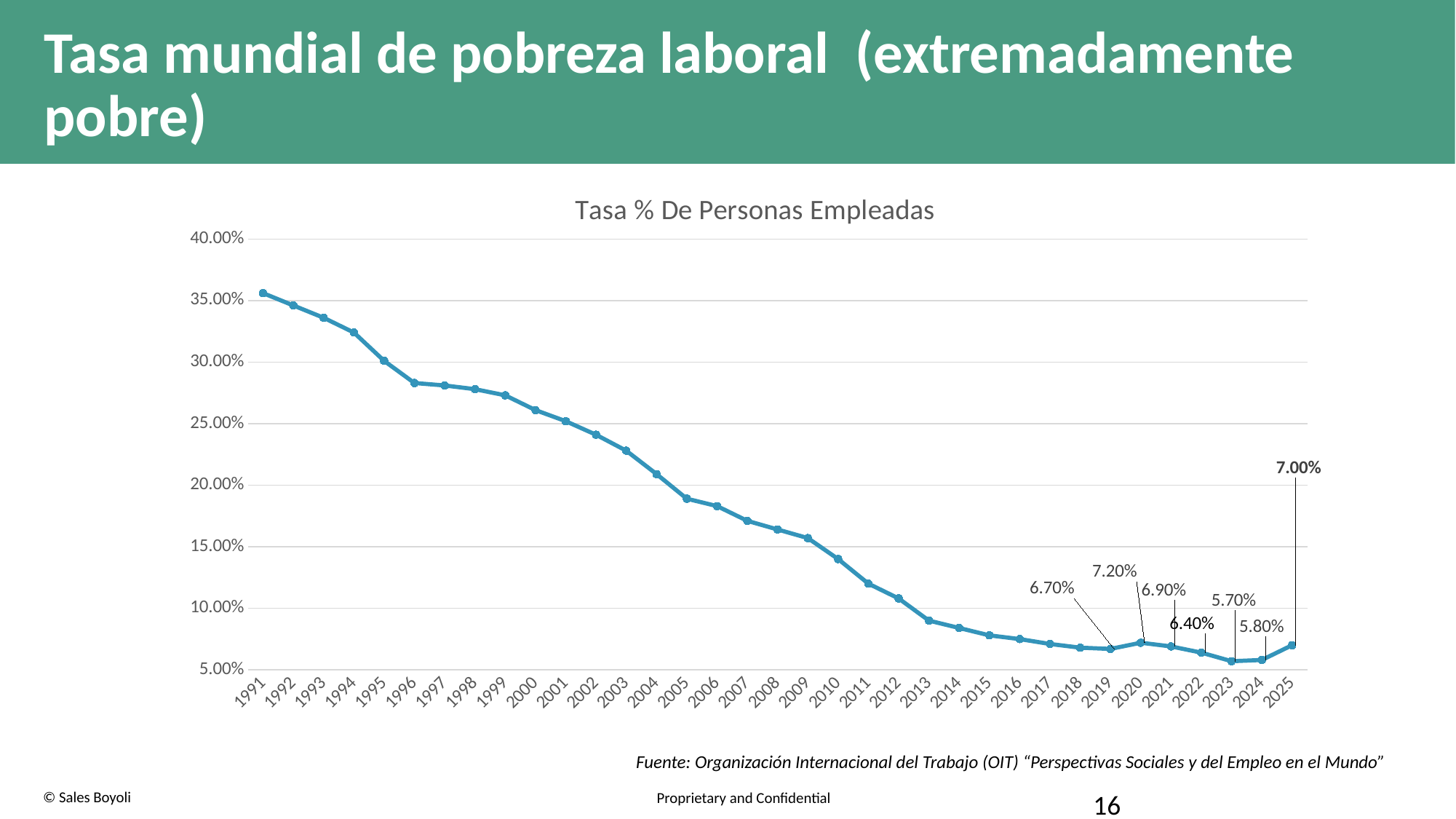
Is the value for 2010 greater or less than 15.00%? less Which is larger, the value for 2021 or the value for 2022? 2021 What is the value for 2023? 5.70% What is the value for 2020? 7.20% What kind of chart is shown on the slide? line chart What is the title of the chart? Tasa % De Personas Empleadas Which year has the lowest value among the labelled points? 2023 What is the difference between the values for 2020 and 2019? 0.50% Overall, do the values rise or fall from 1991 to 2025? fall Which year has the highest value on the chart? 1991 What is the value for 2025? 7.00% What is the value for 2019? 6.70%